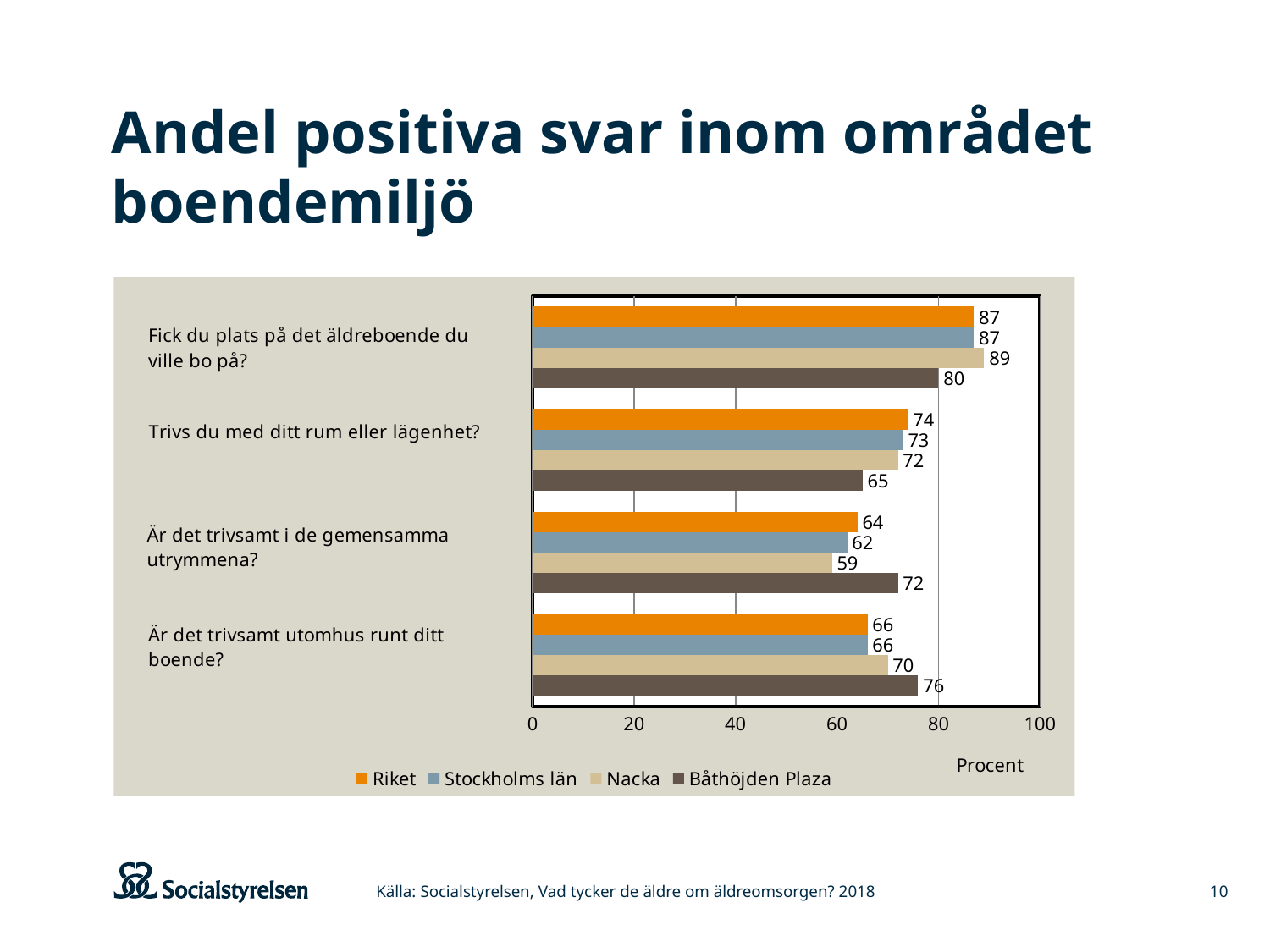
What is the label on the horizontal axis of the chart? Procent What is the value for Stockholms län on "Är det trivsamt i de gemensamma utrymmena?"? 62 Which series has the lowest value on "Fick du plats på det äldreboende du ville bo på?"? Båthöjden Plaza How many series does the legend list? 4 Which series has the highest value on "Är det trivsamt i de gemensamma utrymmena?"? Båthöjden Plaza How many question categories are shown on the chart? 4 What is the difference between the Båthöjden Plaza and Nacka values on "Är det trivsamt i de gemensamma utrymmena?"? 13 What is the value for Båthöjden Plaza on "Trivs du med ditt rum eller lägenhet?"? 65 What is the value for Nacka on "Fick du plats på det äldreboende du ville bo på?"? 89 What kind of chart is shown on the slide? Bar chart What is the value for Riket on "Är det trivsamt utomhus runt ditt boende?"? 66 On "Är det trivsamt utomhus runt ditt boende?", which is larger: the value for Nacka or the value for Båthöjden Plaza? Båthöjden Plaza